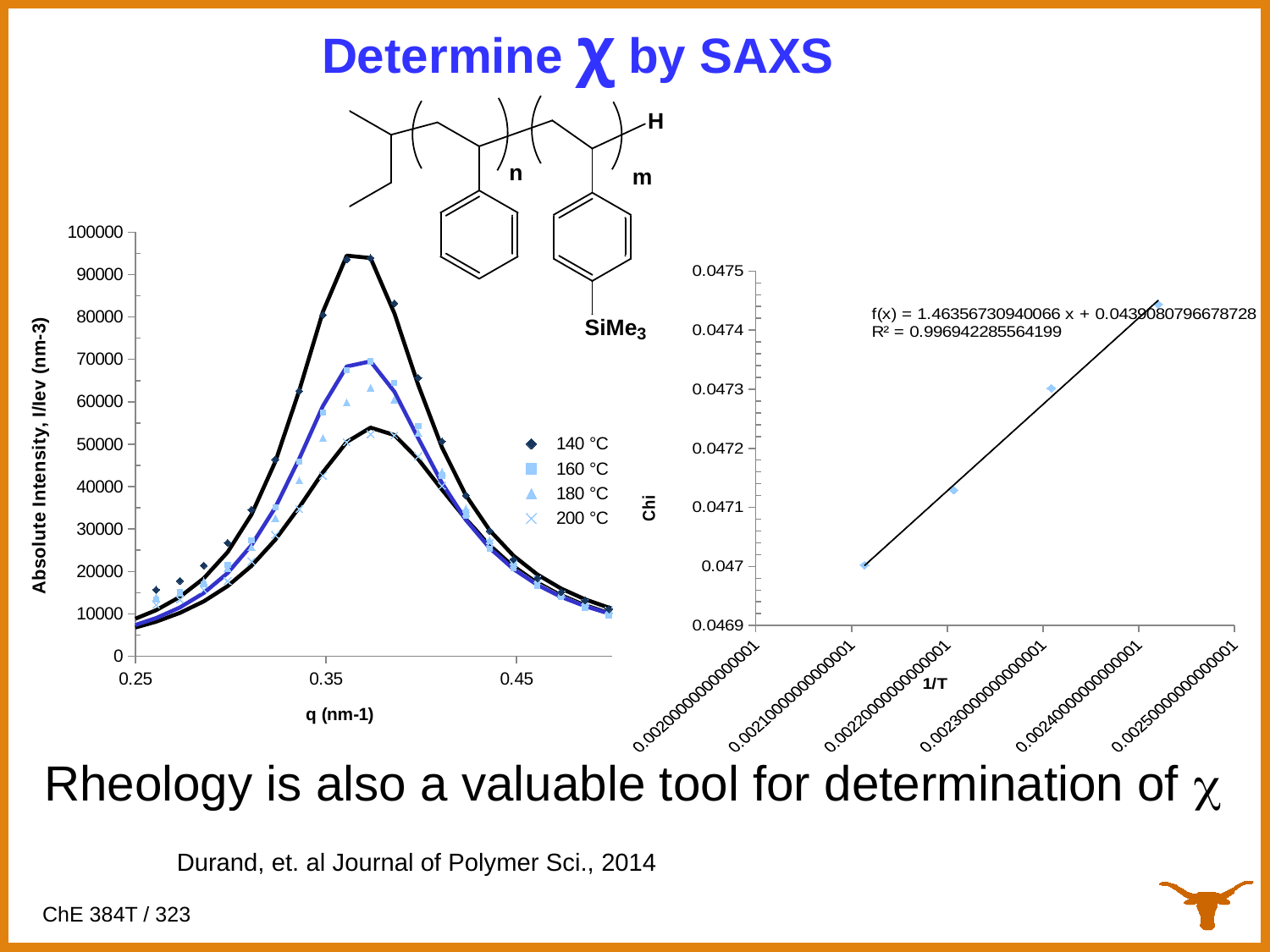
On the right chart (Chi vs 1/T), do the Chi values rise or fall as 1/T increases? rise On the right chart (Chi vs 1/T), what R² value is shown for the fitted line? 0.996942285564199 On the left chart (Absolute Intensity vs q), which temperature series has the lowest peak intensity? 200 °C On the right chart (Chi vs 1/T), is the Chi value of the highest point greater or less than 0.0473? greater On the left chart (Absolute Intensity vs q), is the peak value of the 140 °C series greater or less than 90000? greater On the left chart (Absolute Intensity vs q), how many series does the legend list? 4 On the left chart (Absolute Intensity vs q), which temperature series reaches the highest peak intensity? 140 °C On the left chart (Absolute Intensity vs q), which series has the larger peak intensity, 160 °C or 200 °C? 160 °C On the left chart, what is the label of the x axis? q (nm-1) On the right chart (Chi vs 1/T), how many data points are plotted? 4 On the right chart (Chi vs 1/T), what is the label of the y axis? Chi On the left chart (Absolute Intensity vs q), is the peak value of the 200 °C series greater or less than 60000? less